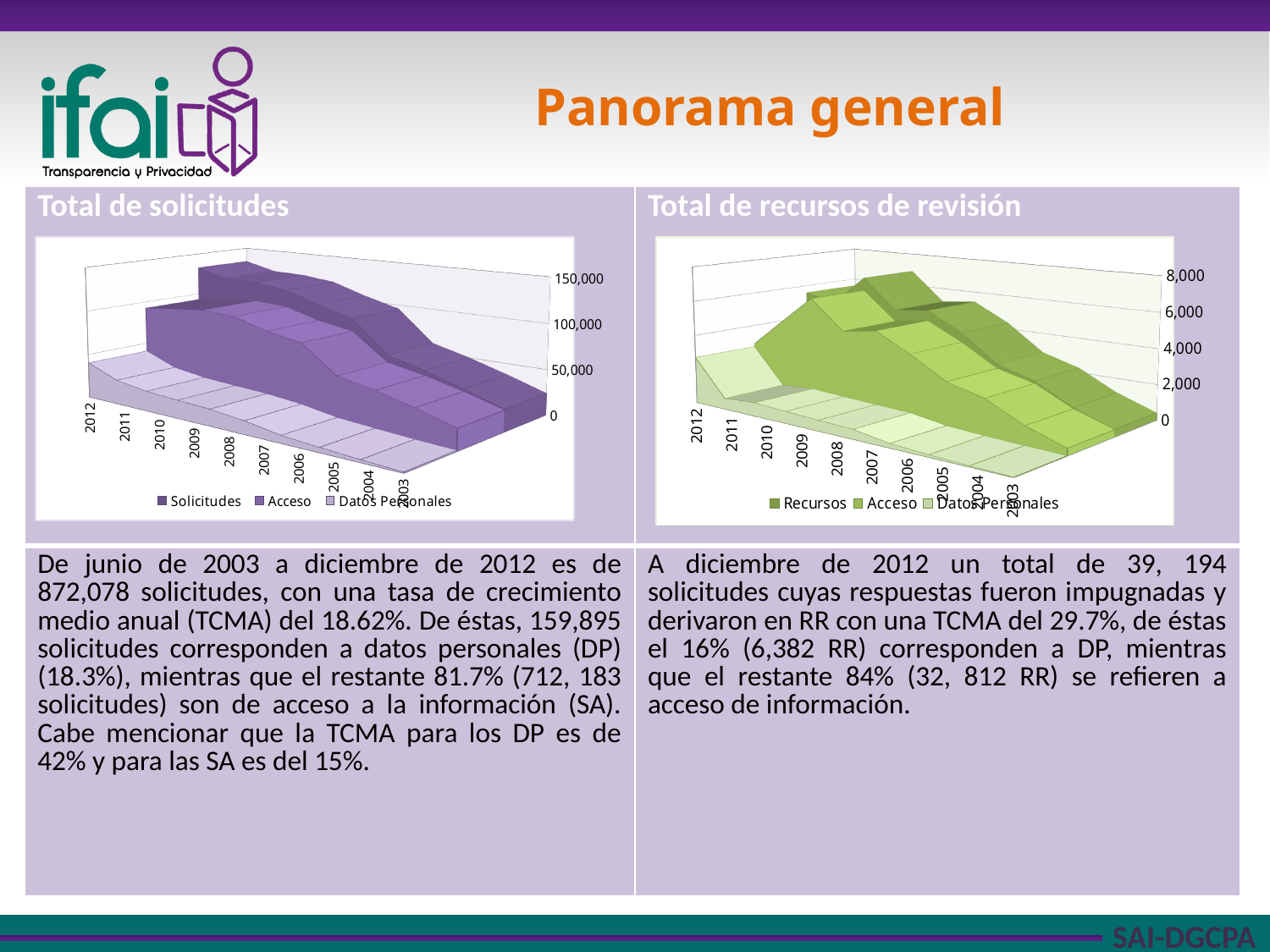
How many series does the legend of the 'Total de recursos de revisión' chart list? 3 What kind of chart is the 'Total de solicitudes' chart? area chart In the 'Total de solicitudes' chart, is the value for Datos Personales in 2003 greater or less than 50,000? less How many years are shown on the x axis of the 'Total de recursos de revisión' chart? 10 How many series does the legend of the 'Total de solicitudes' chart list? 3 In the 'Total de recursos de revisión' chart, do the Recursos values rise or fall from 2003 to 2012? rise In the 'Total de solicitudes' chart, do the Solicitudes values rise or fall from 2003 to 2012? rise What kind of chart is the 'Total de recursos de revisión' chart? area chart In the 'Total de solicitudes' chart, which series are listed in the legend? Solicitudes, Acceso, Datos Personales How many years are shown on the x axis of the 'Total de solicitudes' chart? 10 In the 'Total de recursos de revisión' chart, which series are listed in the legend? Recursos, Acceso, Datos Personales In the 'Total de recursos de revisión' chart, is the value for Recursos in 2003 greater or less than 2,000? less